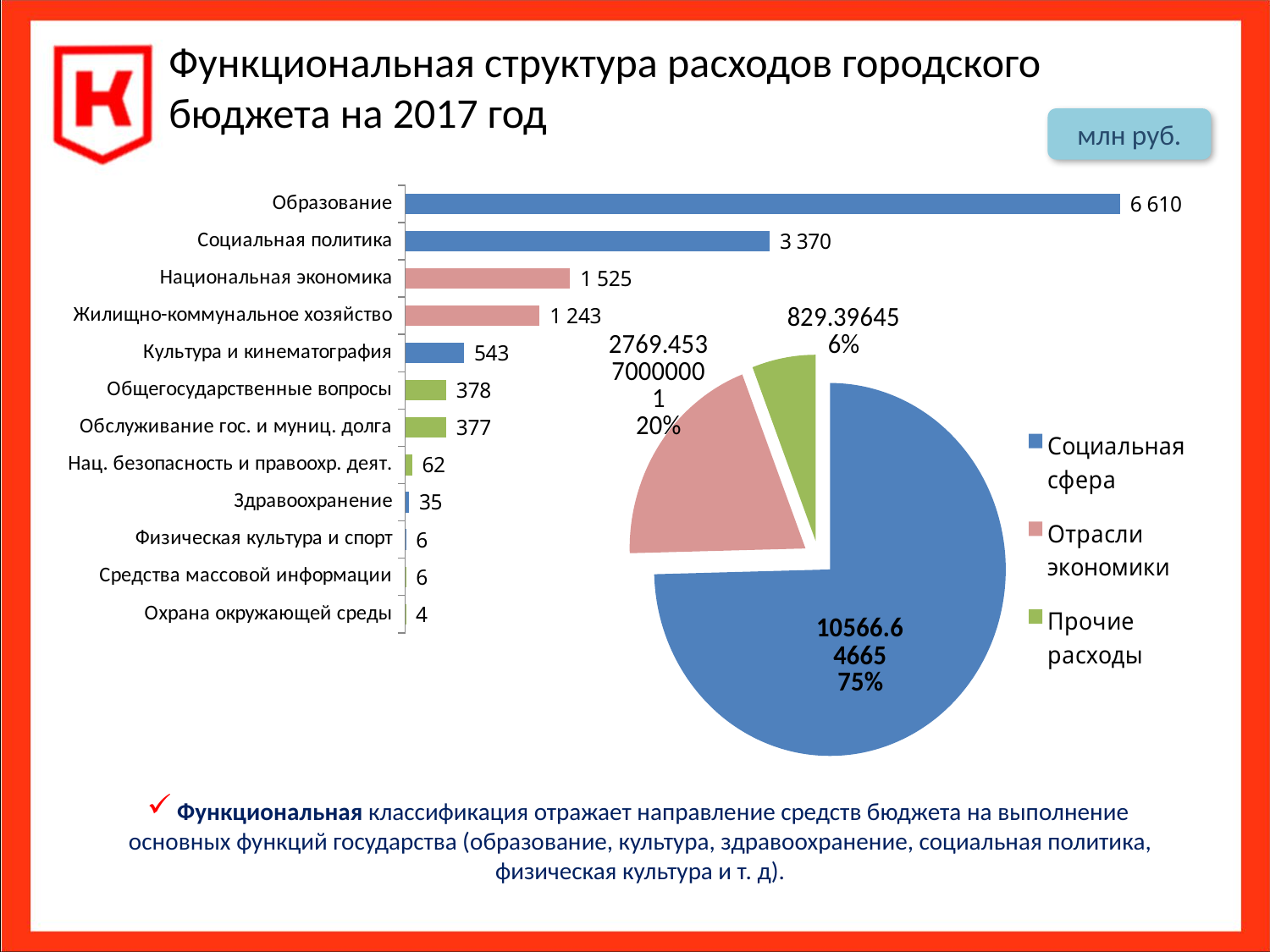
On the bar chart, which category has the highest value? Образование On the bar chart, what is the value for Образование? 6 610 How many entries does the pie chart's legend list? 3 What type of chart is the chart on the left of the slide? Bar chart On the pie chart, what share does Социальная сфера have? 75% On the bar chart, which is larger: Национальная экономика or Культура и кинематография? Национальная экономика On the pie chart, what share does Прочие расходы have? 6% On the bar chart, what is the value for Жилищно-коммунальное хозяйство? 1 243 On the bar chart, which category has the lowest value? Охрана окружающей среды On the bar chart, what is the difference between Образование and Социальная политика? 3 240 On the bar chart, what is the value for Здравоохранение? 35 How many categories does the bar chart show? 12